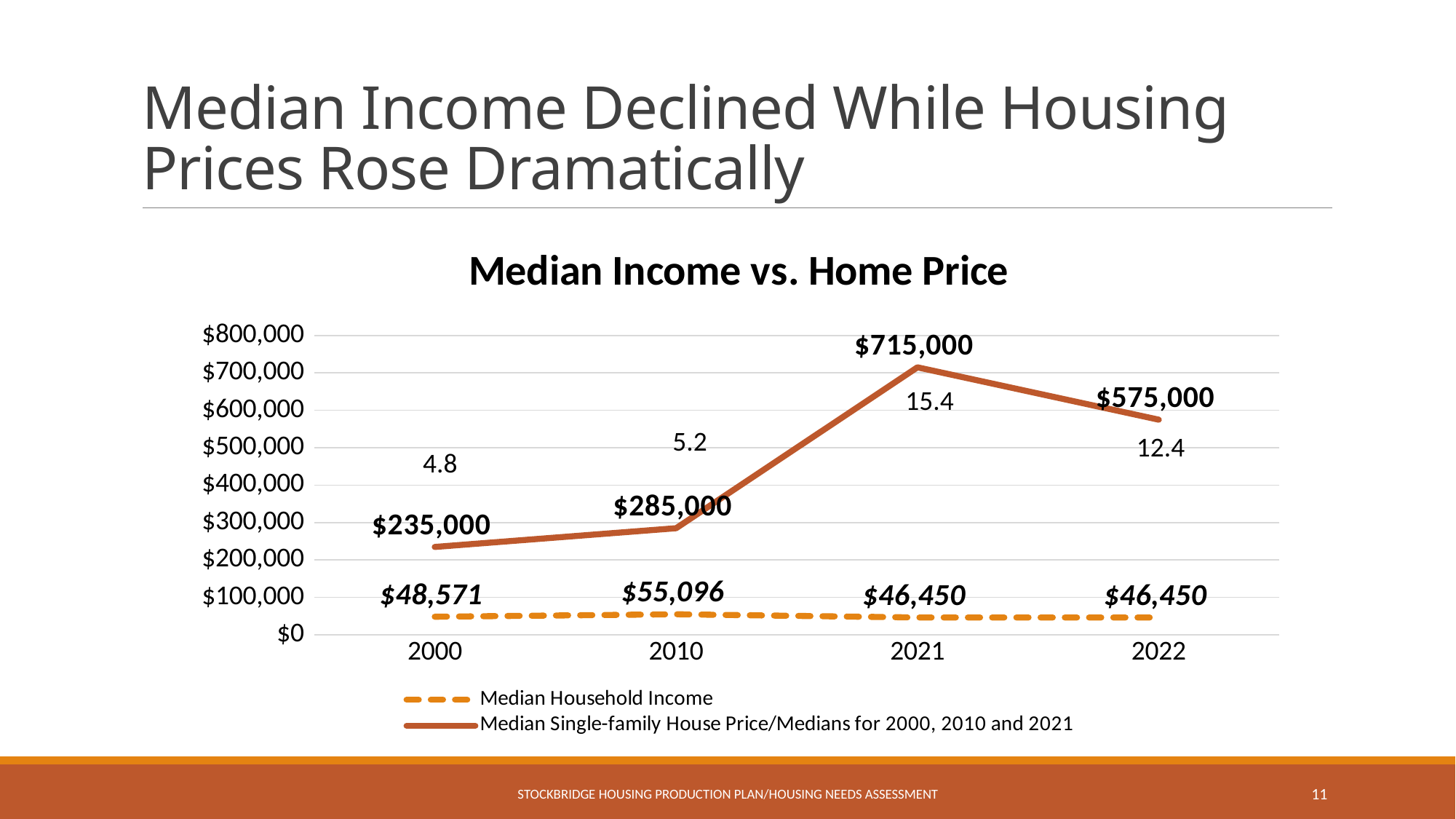
What is the difference between the Median Single-family House Price in 2021 and in 2000? $480,000 What is the Median Single-family House Price for 2022? $575,000 In which year is the Median Single-family House Price highest? 2021 How many years are shown on the x axis? 4 Which is larger, the Median Single-family House Price in 2010 or in 2022? 2022 In which year is the Median Single-family House Price lowest? 2000 What is the Median Household Income for 2000? $48,571 What is the Median Household Income for 2010? $55,096 What is the Median Single-family House Price for 2021? $715,000 How many series does the legend list? 2 What is the difference between the Median Household Income in 2010 and in 2021? $8,646 What kind of chart is shown on the slide? Line chart